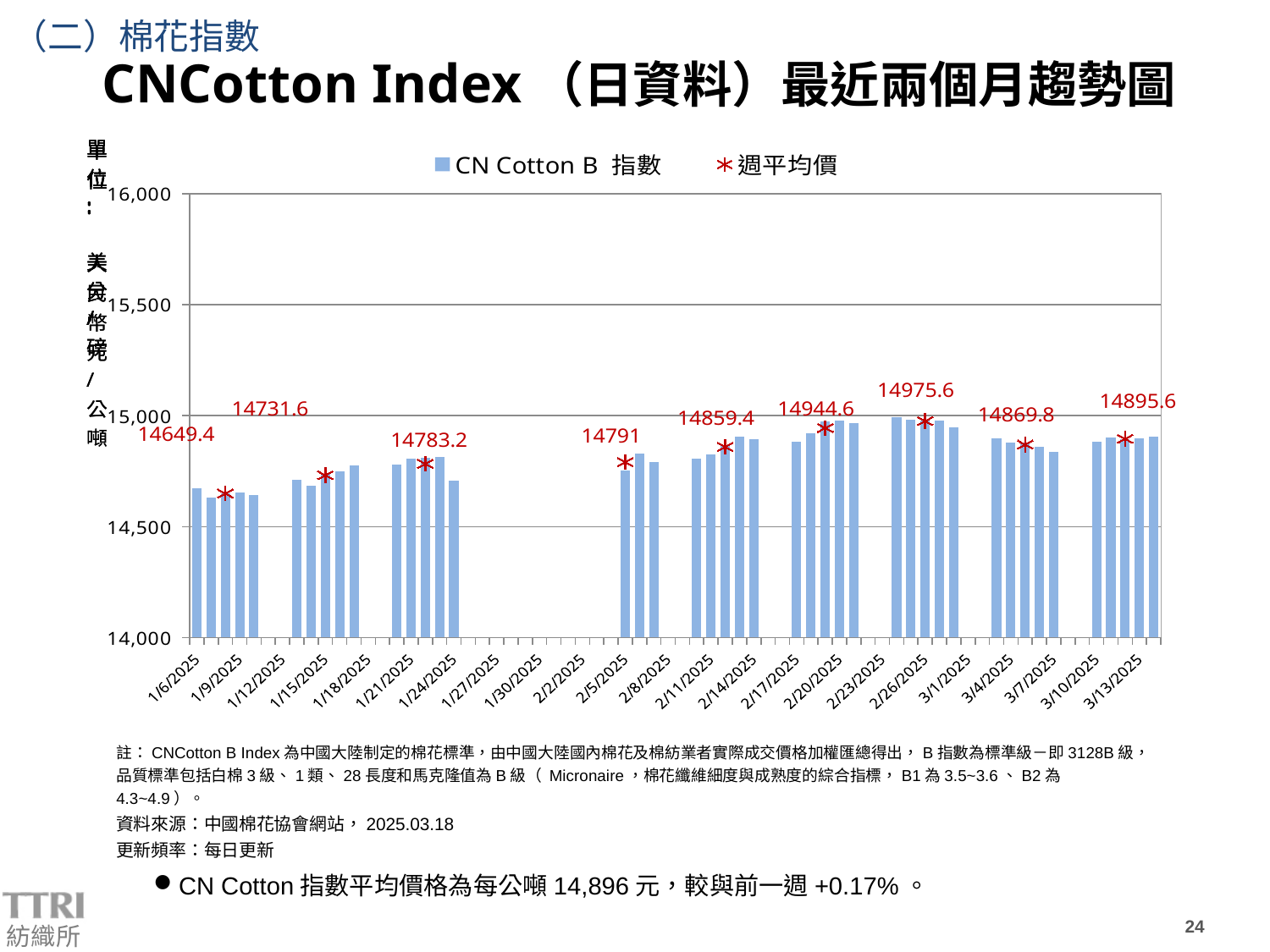
Is the CN Cotton B 指數 bar at 1/6/2025 greater or less than 14,500? greater What is the difference between the last labelled 週平均價 (14895.6) and the one before it (14869.8)? 25.8 From the first labelled 週平均價 to the last, does the weekly average rise or fall overall? rise What is the rightmost (latest) 週平均價 value labelled on the chart? 14895.6 How many 週平均價 markers are plotted on the chart? 9 How many series does the legend list? 2 Which is larger, the 週平均價 labelled 14944.6 or the one labelled 14869.8? 14944.6 What is the leftmost (earliest) 週平均價 value labelled on the chart? 14649.4 What is the highest 週平均價 value labelled on the chart? 14975.6 What is the difference between the highest and lowest labelled 週平均價 values? 326.2 What is the lowest 週平均價 value labelled on the chart? 14649.4 What kind of chart is used to plot the CN Cotton B 指數 series? bar chart